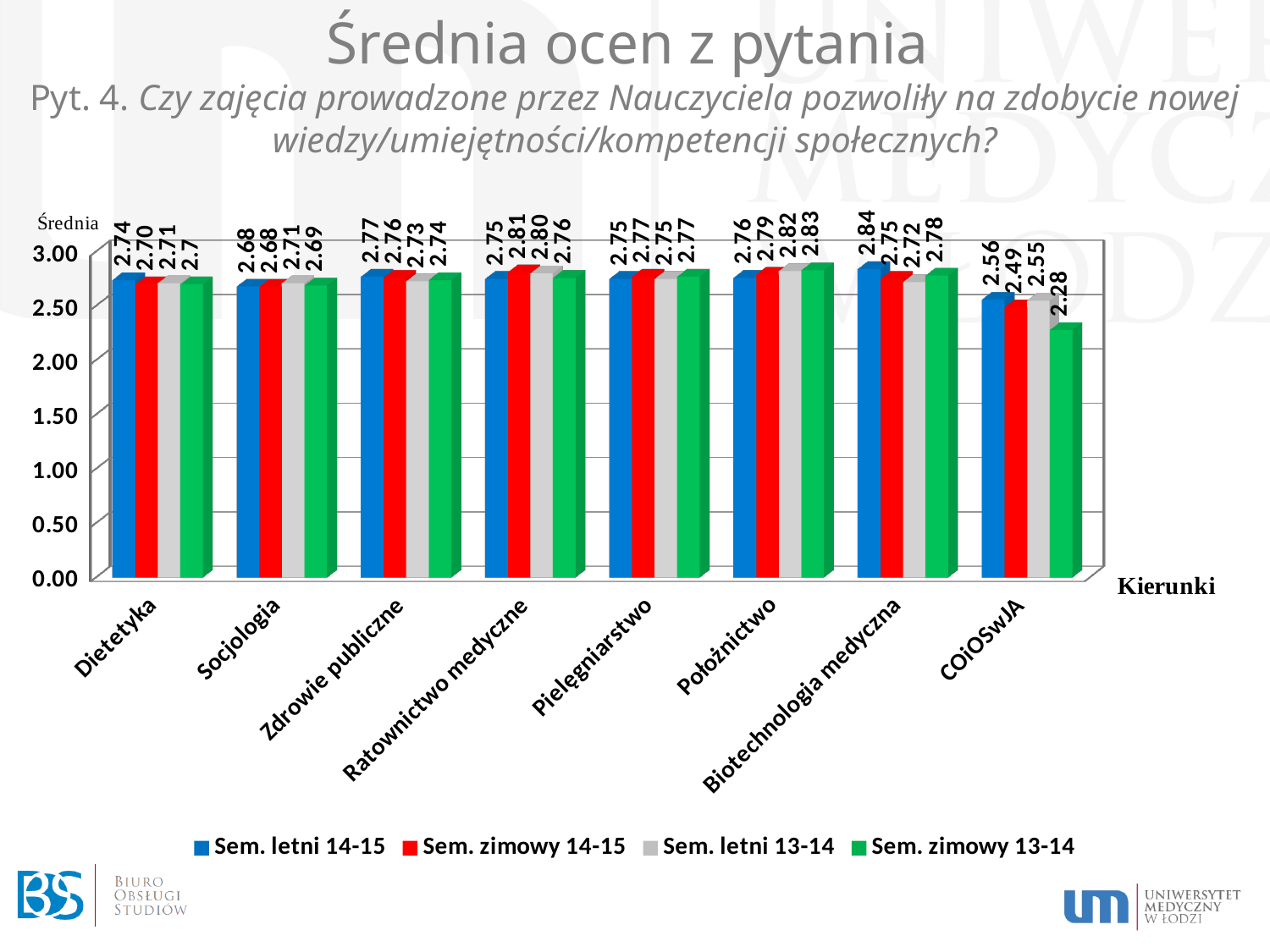
How many categories (kierunki) are shown on the x axis? 8 Which category has the highest value in the Sem. letni 14-15 series? Biotechnologia medyczna What is the value for Ratownictwo medyczne in the Sem. zimowy 14-15 series? 2.81 How many series does the legend list? 4 What is the value for Położnictwo in the Sem. letni 13-14 series? 2.82 What is the difference between the Sem. letni 14-15 value and the Sem. zimowy 13-14 value for COiOSwJA? 0.28 What kind of chart is shown on the slide? Bar chart Which category has the lowest value in the Sem. zimowy 13-14 series? COiOSwJA What is the value for Dietetyka in the Sem. letni 14-15 series? 2.74 What is the value for COiOSwJA in the Sem. zimowy 13-14 series? 2.28 Which colour represents the Sem. zimowy 14-15 series? Red Which is larger for Biotechnologia medyczna: the Sem. letni 14-15 value or the Sem. letni 13-14 value? Sem. letni 14-15